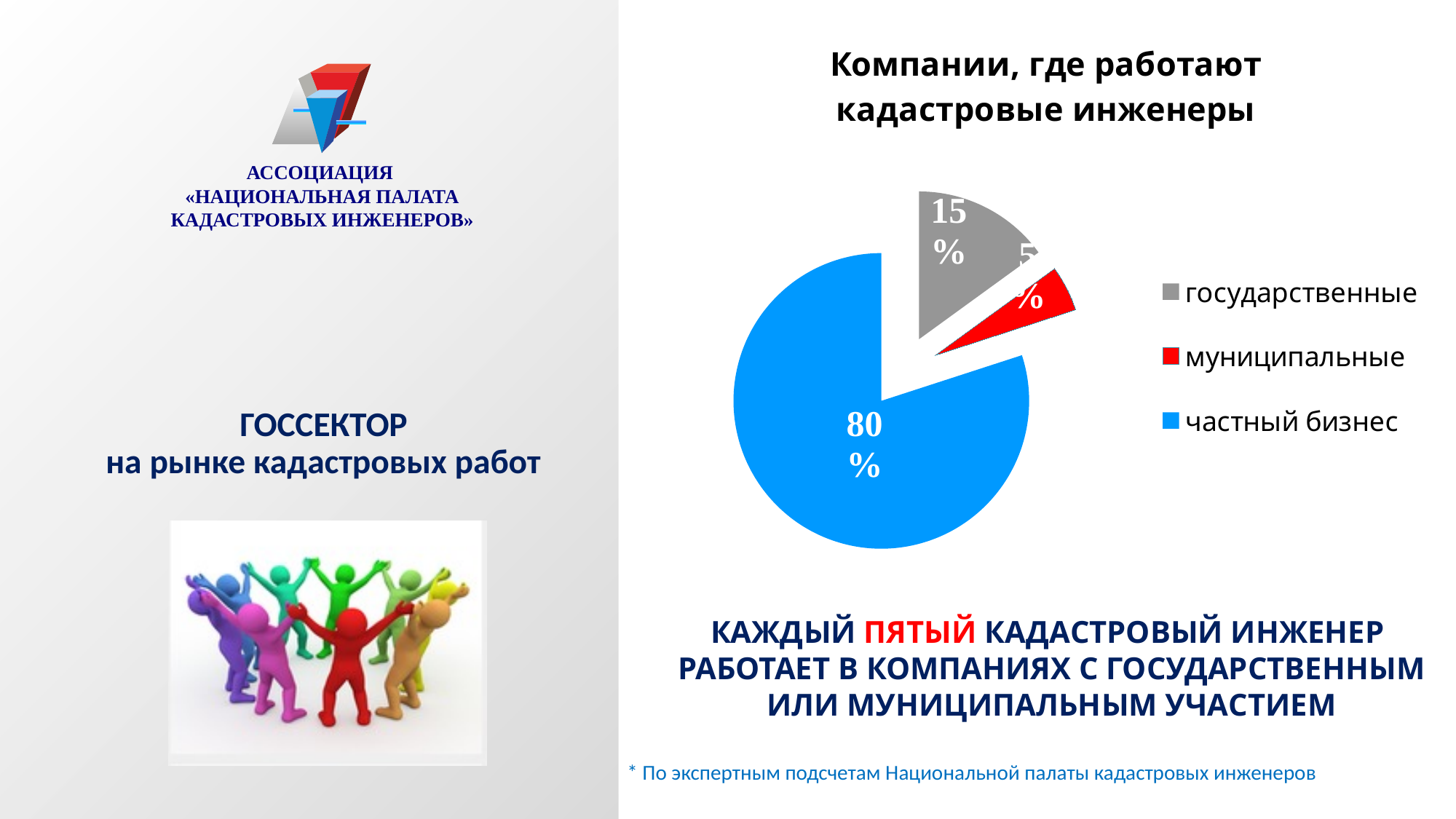
Which is larger, the slice for государственные or the slice for муниципальные? государственные Which category has the smallest slice of the pie? муниципальные How many slices does the pie chart have? 3 How many entries does the legend list? 3 Which category has the largest slice of the pie? частный бизнес What kind of chart is shown on the slide? pie chart What is the difference between the share for частный бизнес and the share for государственные? 65% What is the value shown for муниципальные? 5% What is the value shown for государственные? 15% What share of the pie does частный бизнес have? 80% What is the title of the chart? Компании, где работают кадастровые инженеры What colour is the slice for частный бизнес? blue